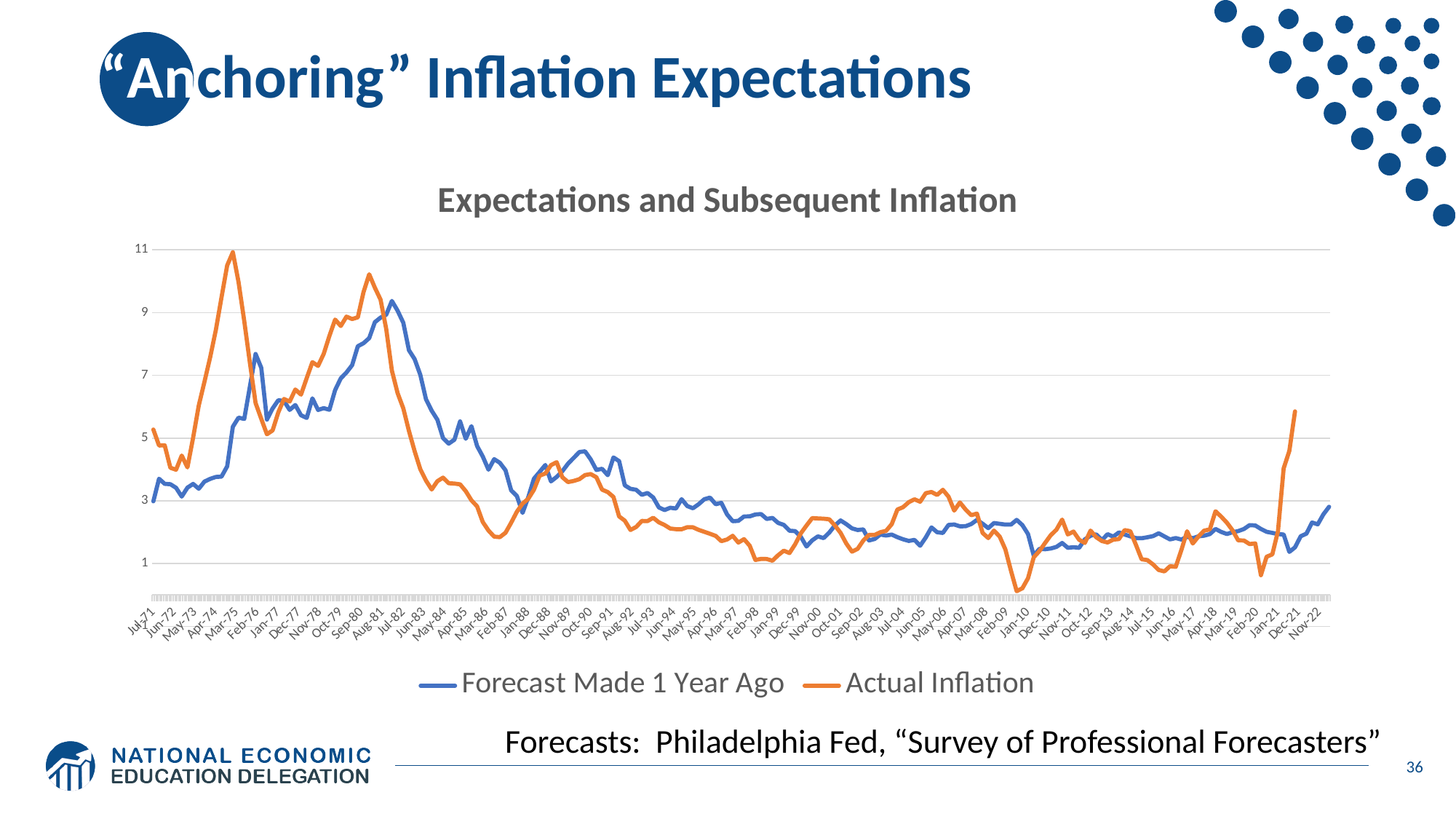
Is the value of Actual Inflation around Dec-21 greater or less than 5? greater Which series reaches the highest peak on the chart? Actual Inflation Is the value of Actual Inflation around Jan-10 greater or less than 1? less Around Jan-10, which series has the higher value, Forecast Made 1 Year Ago or Actual Inflation? Forecast Made 1 Year Ago How many series does the legend list? 2 What kind of chart is shown on the slide? line chart Does Actual Inflation rise or fall between Jul-82 and Jun-83? fall Around Mar-75, which series has the higher value, Forecast Made 1 Year Ago or Actual Inflation? Actual Inflation Which series is drawn in orange? Actual Inflation Is the value of Actual Inflation around Mar-75 greater or less than 9? greater What is the title of the chart? Expectations and Subsequent Inflation